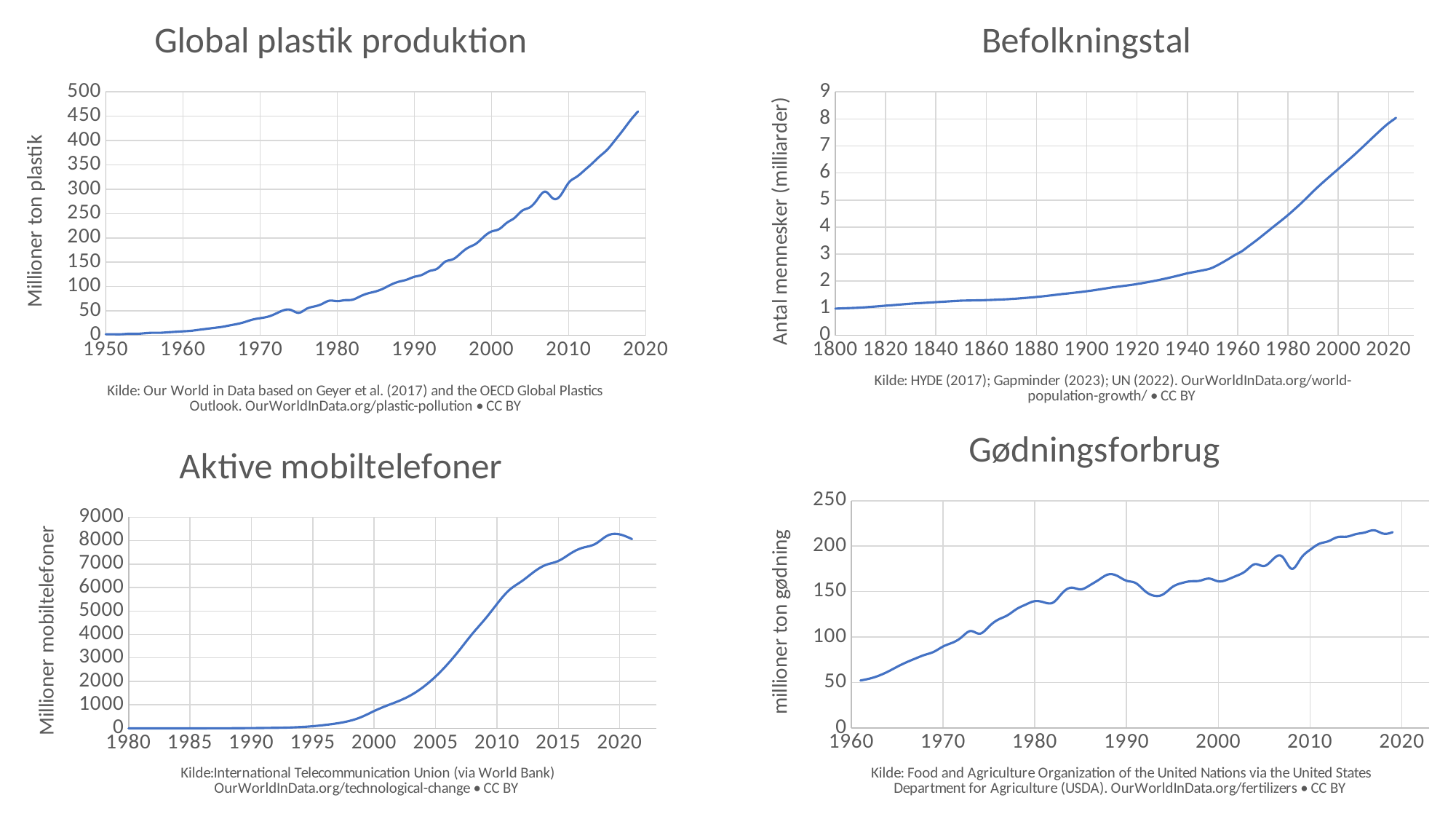
In the "Gødningsforbrug" chart, is the value for 2010 greater or less than 150? greater In the "Befolkningstal" chart, is the value for 1900 greater or less than 2? less In the "Befolkningstal" chart, is the value for 2020 greater or less than 7? greater How many charts are shown on the slide? 4 What kind of chart is the "Global plastik produktion" chart? Line chart What is the y-axis label of the "Befolkningstal" chart? Antal mennesker (milliarder) In the "Global plastik produktion" chart, do the values rise or fall from 1950 to 2020? Rise In the "Gødningsforbrug" chart, do the values generally rise or fall from 1960 to 2020? Rise